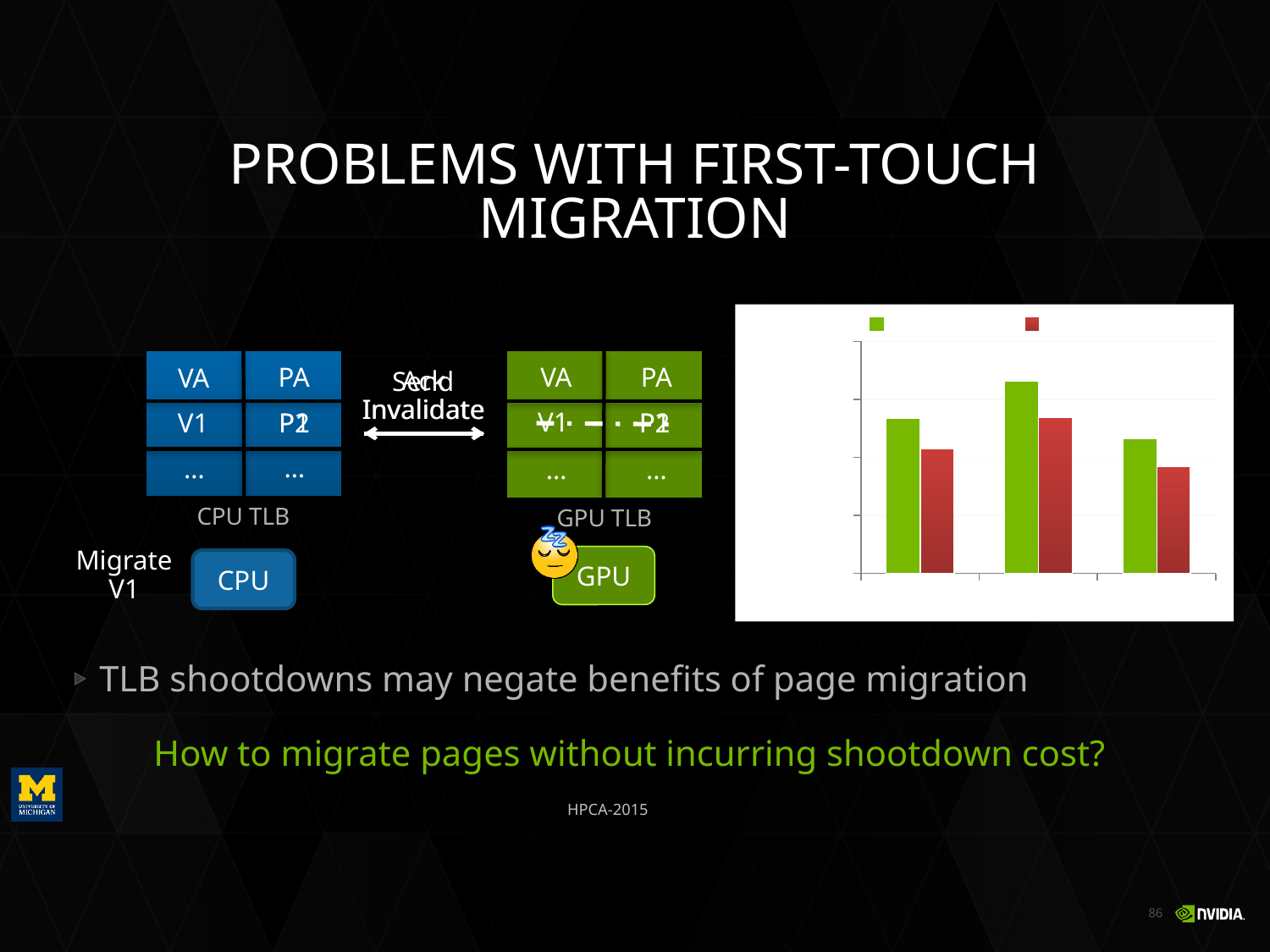
What two colours are used for the bars in the chart? green and red In the right group of bars in the chart, which bar is shorter, the green one or the red one? red In the left group of bars in the chart, which bar is taller, the green one or the red one? green What kind of chart is shown on the right side of the slide? bar chart In the chart, which group of bars has the tallest green bar: the left, middle, or right group? middle In the middle group of bars in the chart, which bar is taller, the green one or the red one? green Which group has the shortest red bar in the chart: the left, middle, or right group? right How many series does the legend of the chart list? 2 How many groups of bars are plotted in the chart? 3 Are the bars in the chart vertical or horizontal? vertical In the chart, which group of bars has the tallest red bar: the left, middle, or right group? middle